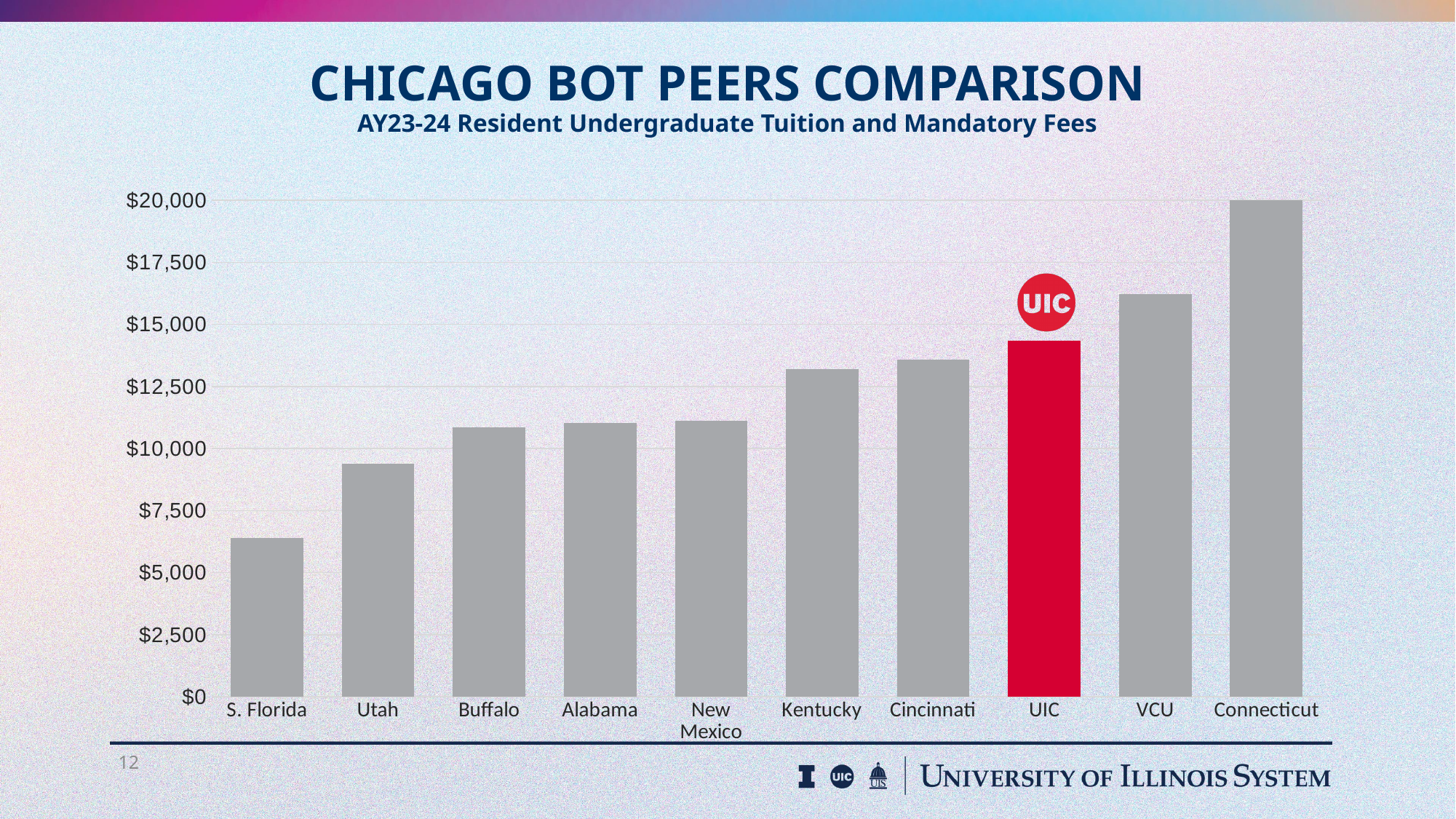
Which institution has the lowest resident undergraduate tuition and mandatory fees? S. Florida Do the values rise or fall moving from left to right across the chart? Rise Is the value for UIC greater or less than $15,000? less How many institutions are shown on the chart? 10 What kind of chart is shown on the slide? Bar chart Is the value for Kentucky greater or less than $12,500? greater Is the value for S. Florida greater or less than $7,500? less Which institution has the highest resident undergraduate tuition and mandatory fees? Connecticut Which is larger, the value for UIC or the value for Cincinnati? UIC Which bar on the chart is highlighted in red? UIC